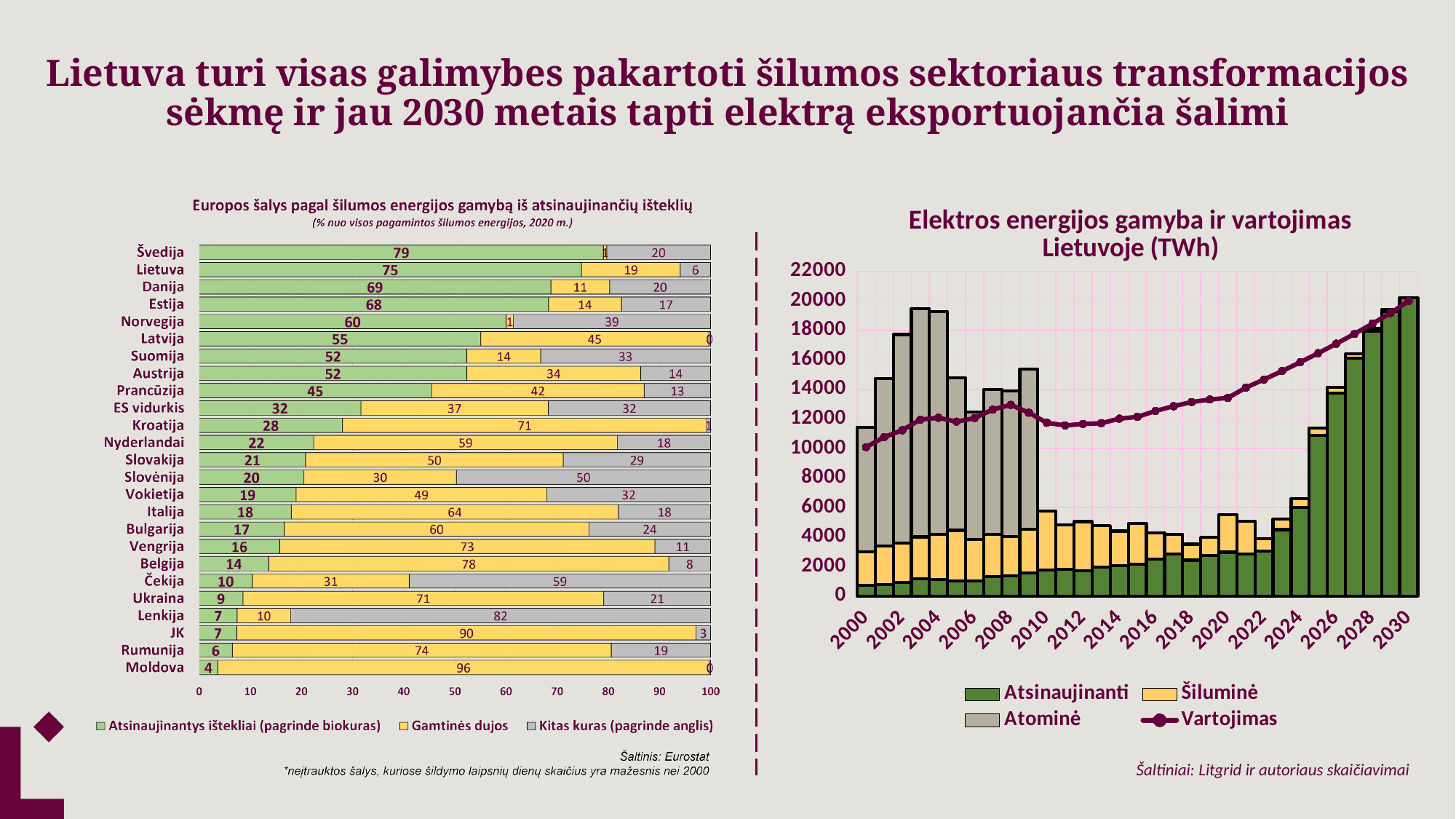
How many countries/categories are listed in the left chart? 25 In the left chart, which country has the highest share of Atsinaujinantys ištekliai? Švedija In the left chart, what is the difference between the Atsinaujinantys ištekliai values of Švedija and Lietuva? 4 In the right chart, is the Vartojimas value for 2030 greater or less than 18000? greater In the left chart, what is the Kitas kuras (pagrinde anglis) value for Lenkija? 82 In the left chart, which country has the lowest share of Atsinaujinantys ištekliai? Moldova How many series does the legend of the left chart list? 3 In the left chart (Europos šalys pagal šilumos energijos gamybą iš atsinaujinančių išteklių), what is the value for Atsinaujinantys ištekliai for Lietuva? 75 In the right chart, does the Vartojimas line rise or fall from 2010 to 2030? rise How many series does the legend of the right chart (Elektros energijos gamyba ir vartojimas Lietuvoje) list? 4 In the left chart, what is the Gamtinės dujos value for Moldova? 96 In the left chart, which has the larger Gamtinės dujos value, Kroatija or Belgija? Belgija